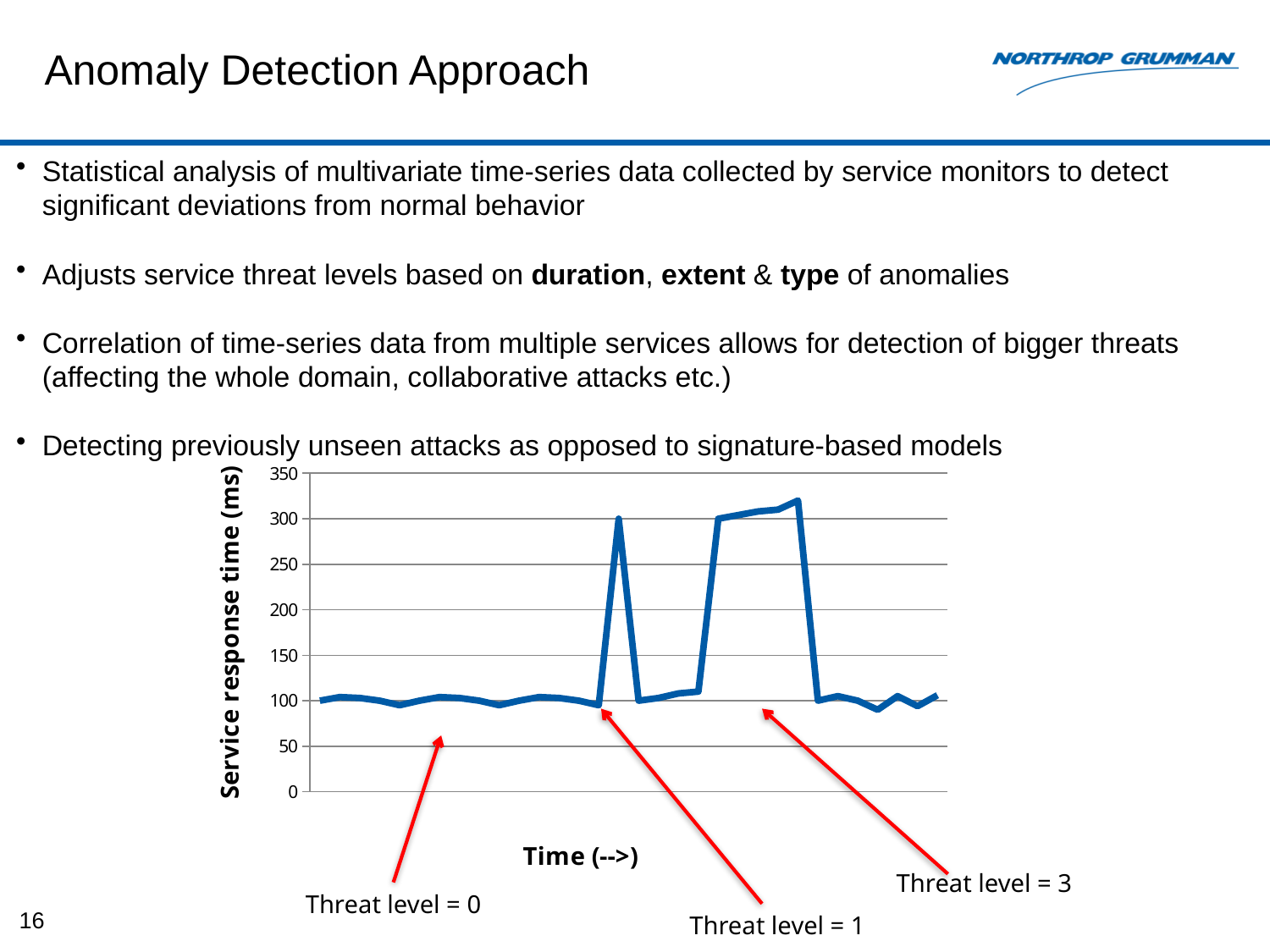
Is the sustained high plateau in the line greater or less than 250? greater What is the title of the vertical axis of the chart? Service response time (ms) Which threat levels are annotated with arrows on the chart? Threat level = 0, Threat level = 1, Threat level = 3 Is the value of the line in the region marked Threat level = 0 greater or less than 50? greater Which is higher: the peak of the sustained plateau or the peak of the first sharp spike? the sustained plateau Is the first sharp spike in the line greater or less than 250? greater What kind of chart is shown on the slide? line chart How many distinct excursions above 200 does the line make? 2 Does the line rise steadily, fall steadily, or stay roughly flat with temporary spikes along the x axis? roughly flat with temporary spikes